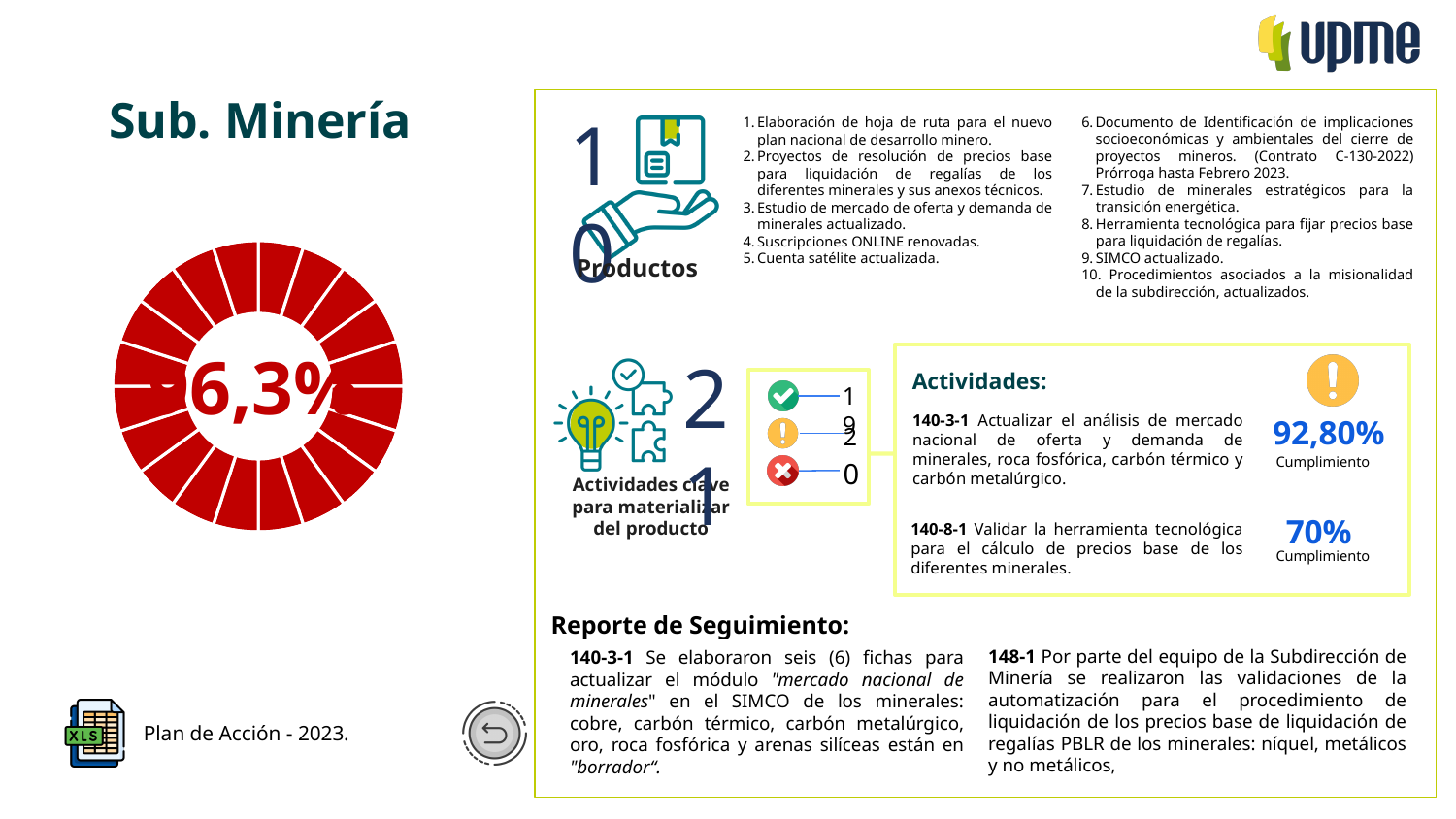
What percentage value is printed in the centre of the donut chart on the left of the slide? 96,3% What kind of chart is shown on the left side of the slide under the title 'Sub. Minería'? pie chart (donut) What colour are the segments of the donut chart on the left of the slide? red Is the value printed in the centre of the donut chart greater or less than 10%? greater